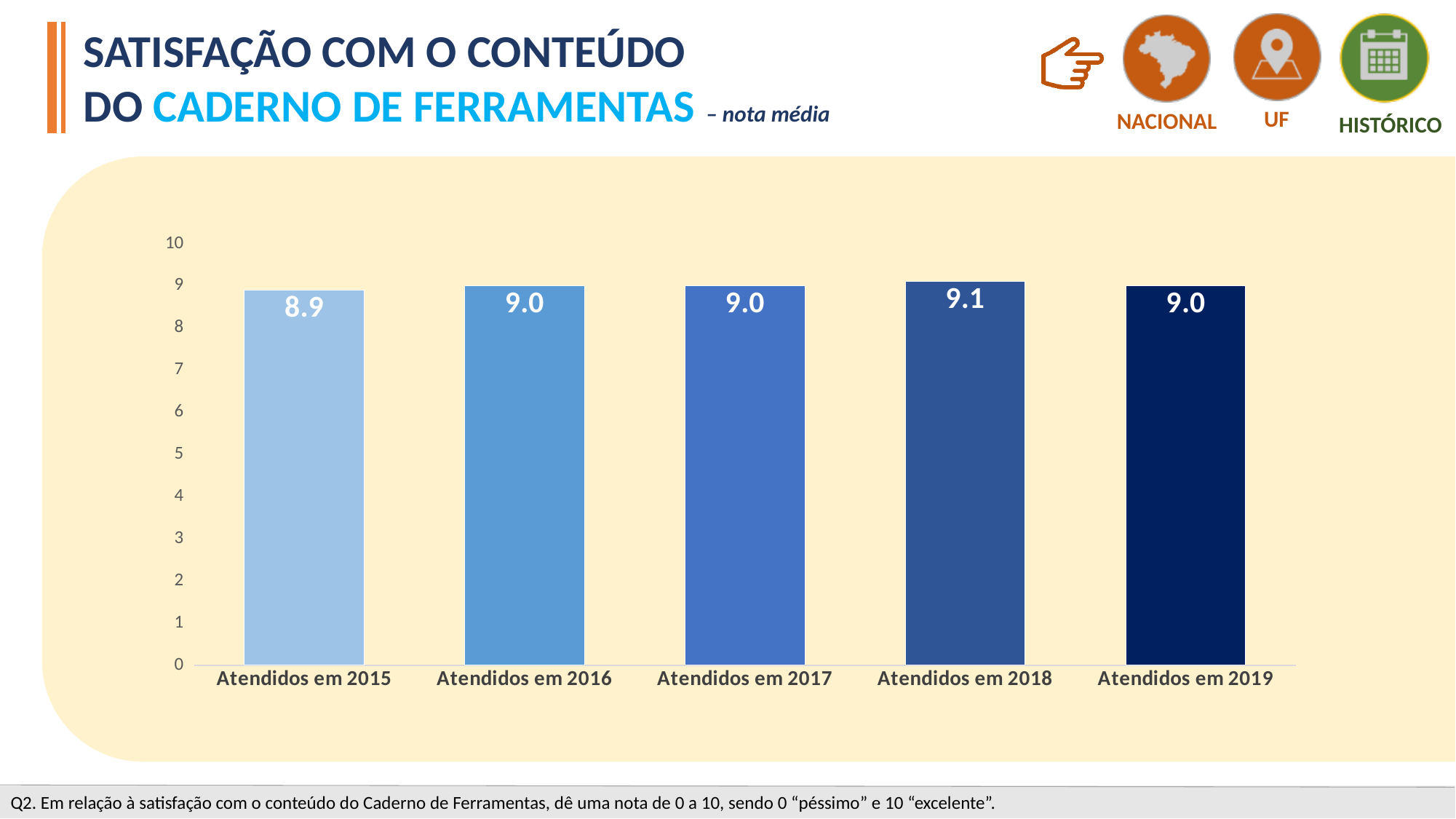
Which category has the lowest value? Atendidos em 2015 Which category has the highest value? Atendidos em 2018 What is the value for Atendidos em 2018? 9.1 What kind of chart is shown on the slide? bar chart How many categories are shown on the x axis? 5 What is the value for Atendidos em 2019? 9.0 What is the difference between the values for Atendidos em 2018 and Atendidos em 2015? 0.2 What is the maximum value shown on the y axis? 10 Is the value for Atendidos em 2017 greater or less than 8? greater What is the value for Atendidos em 2015? 8.9 Which is larger, the value for Atendidos em 2018 or the value for Atendidos em 2016? Atendidos em 2018 What is the value for Atendidos em 2016? 9.0